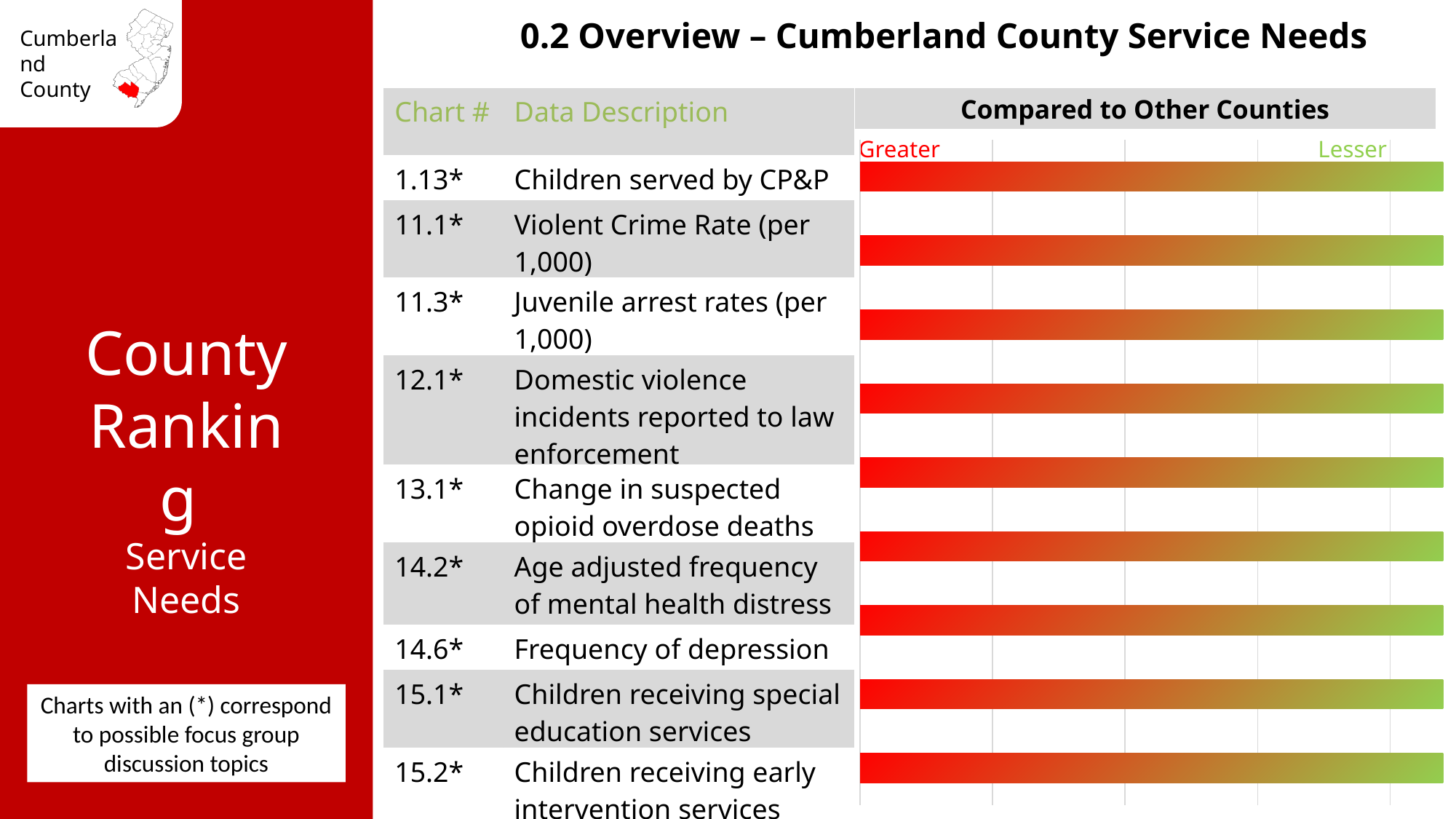
How many data descriptions (rows) are listed in the Compared to Other Counties chart? 9 Which data description is listed for chart 15.2*? Children receiving early intervention services Which chart number is listed for Children served by CP&P? 1.13* What kind of chart is used in the Compared to Other Counties section? bar chart Which data description is listed for chart 13.1*? Change in suspected opioid overdose deaths What is the title of the chart column on the right side of the slide? Compared to Other Counties What labels appear at the left and right ends of the chart's scale? Greater and Lesser Which chart number is listed for Frequency of depression? 14.6*